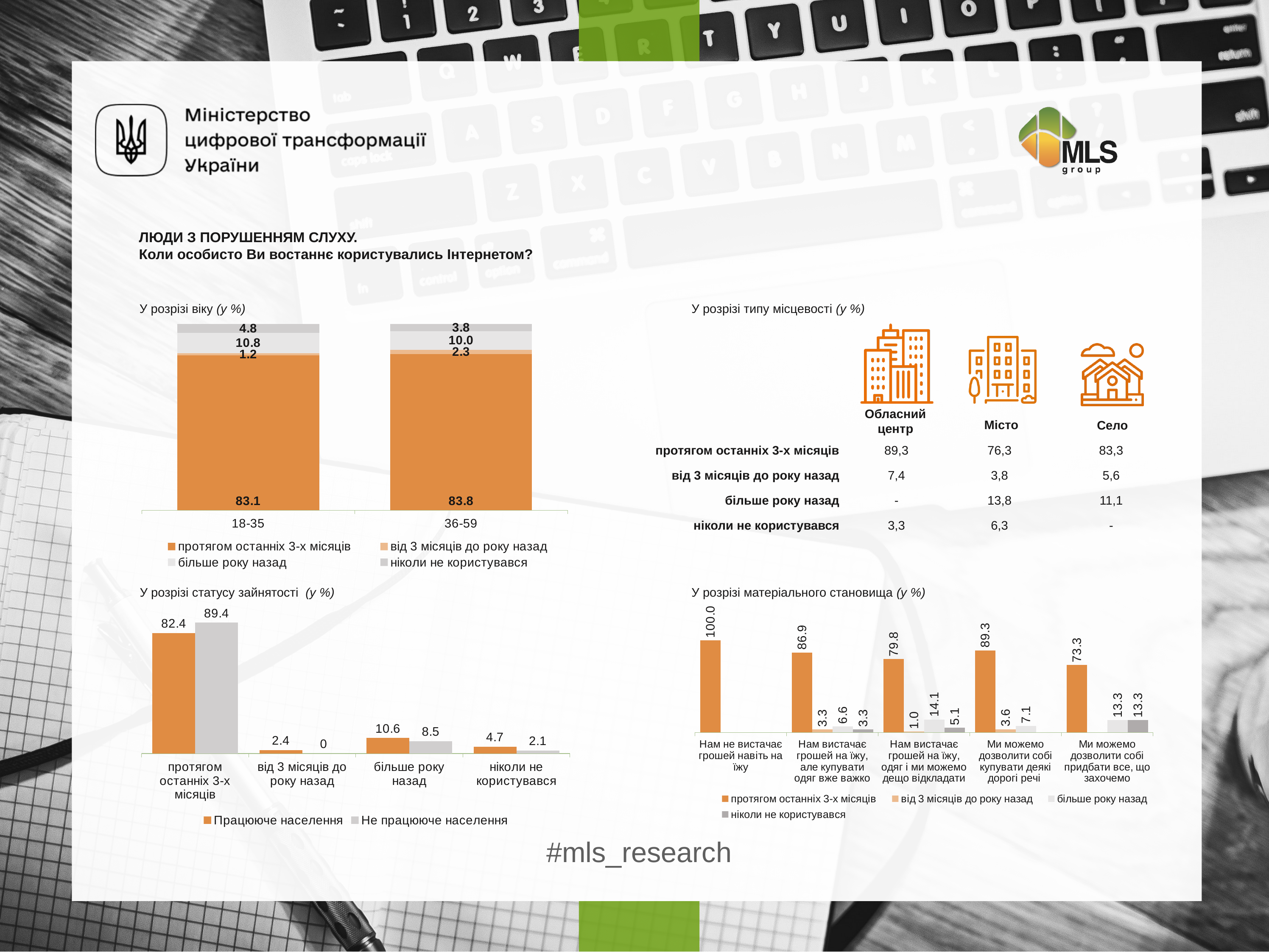
In the chart 'У розрізі статусу зайнятості (у %)', which series has the larger value for 'більше року назад'? Працююче населення In the chart 'У розрізі віку (у %)', what is the difference between the 'більше року назад' values for 18-35 and 36-59? 0.8 In the chart 'У розрізі віку (у %)', what is the value for 'протягом останніх 3-х місяців' in the 18-35 group? 83.1 In the chart 'У розрізі статусу зайнятості (у %)', what is the value for 'Не працююче населення' in the category 'протягом останніх 3-х місяців'? 89.4 In the chart 'У розрізі матеріального становища (у %)', which category has the highest value for 'протягом останніх 3-х місяців'? Нам не вистачає грошей навіть на їжу How many categories are shown on the x axis of the chart 'У розрізі статусу зайнятості (у %)'? 4 How many series does the legend of the chart 'У розрізі віку (у %)' list? 4 What kind of chart is 'У розрізі віку (у %)'? Stacked bar chart In the chart 'У розрізі матеріального становища (у %)', which category has the lowest value for 'протягом останніх 3-х місяців'? Ми можемо дозволити собі придбати все, що захочемо In the chart 'У розрізі віку (у %)', what is the value for 'ніколи не користувався' in the 36-59 group? 3.8 In the chart 'У розрізі статусу зайнятості (у %)', what is the difference between 'Працююче населення' and 'Не працююче населення' for 'ніколи не користувався'? 2.6 In the chart 'У розрізі матеріального становища (у %)', what is the value for 'більше року назад' in the category 'Нам вистачає грошей на їжу, одяг і ми можемо дещо відкладати'? 14.1